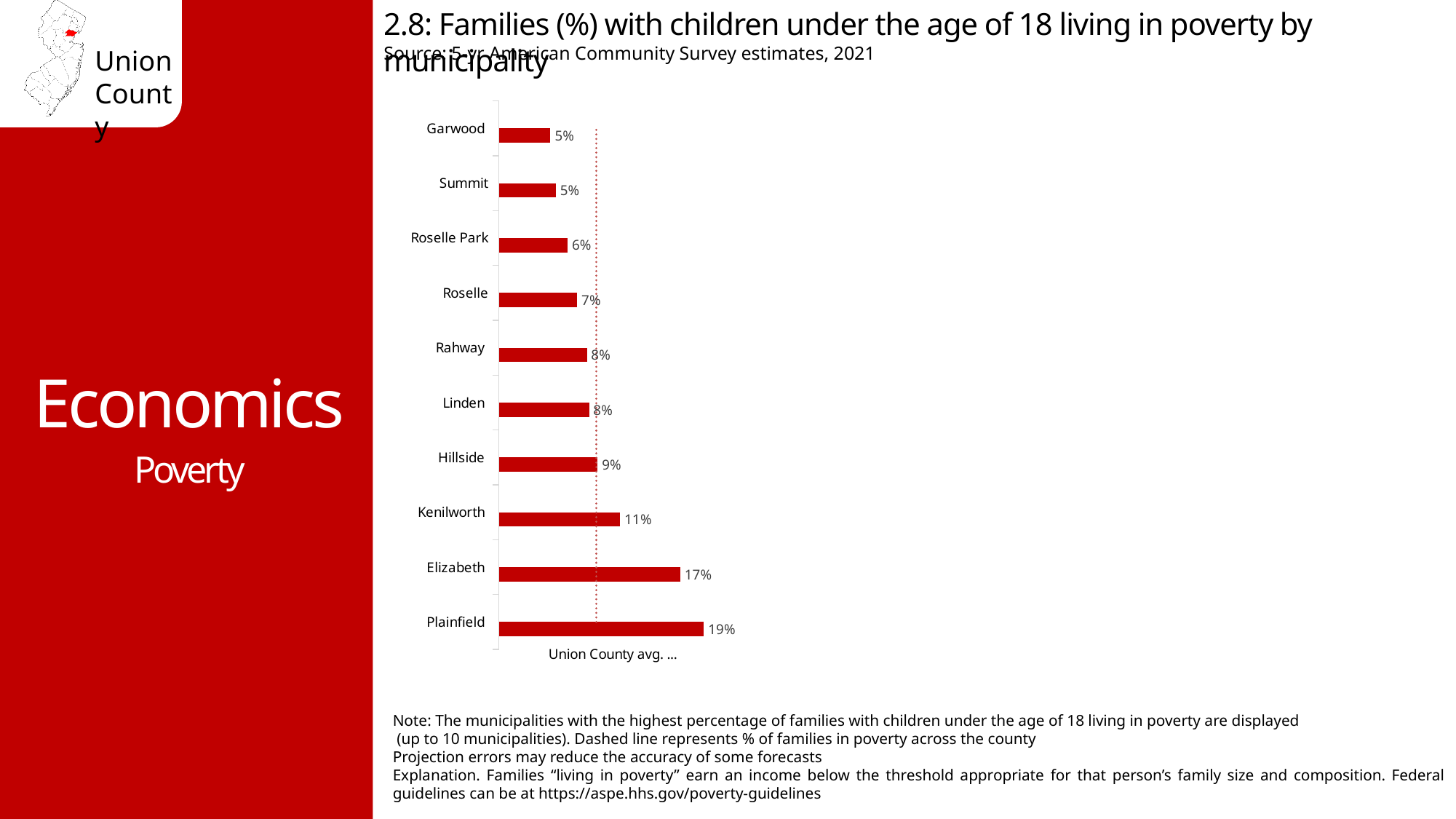
According to the note, what does the dashed line in the chart represent? % of families in poverty across the county What kind of chart is shown on the slide? Bar chart What is the difference between the values for Kenilworth and Hillside? 2 percentage points What is the value for Hillside? 9% Which is larger, the value for Elizabeth or the value for Kenilworth? Elizabeth What is the value for Roselle Park? 6% Which municipality has the highest percentage of families with children under 18 living in poverty? Plainfield How many municipalities are shown in the chart? 10 What is the value for Kenilworth? 11% What is the difference between the values for Plainfield and Elizabeth? 2 percentage points What is the value for Elizabeth? 17% What is the value for Plainfield? 19%